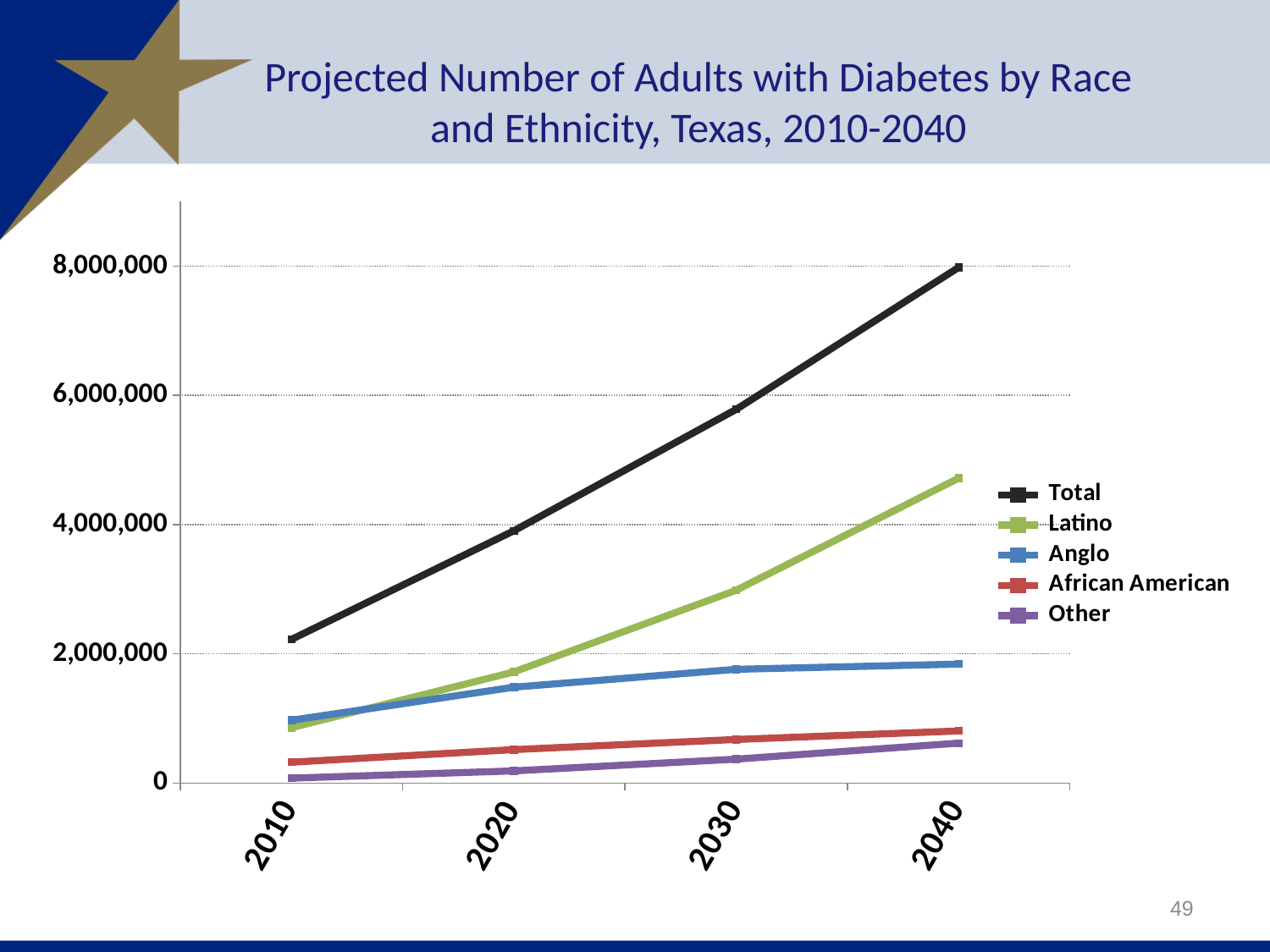
Which series has the highest value in 2040? Total How many series does the legend list? 5 Is the value for Latino in 2020 greater or less than 2,000,000? less Which series has the lowest value in 2040? Other Does the Total line rise or fall from 2010 to 2040? rise How many years are shown along the x axis? 4 In 2040, which is larger, the value for Latino or the value for Anglo? Latino What is the title of the chart? Projected Number of Adults with Diabetes by Race and Ethnicity, Texas, 2010-2040 Is the value for Latino in 2040 greater or less than 4,000,000? greater What kind of chart is shown on the slide? line chart Is the value for Anglo in 2040 greater or less than 2,000,000? less